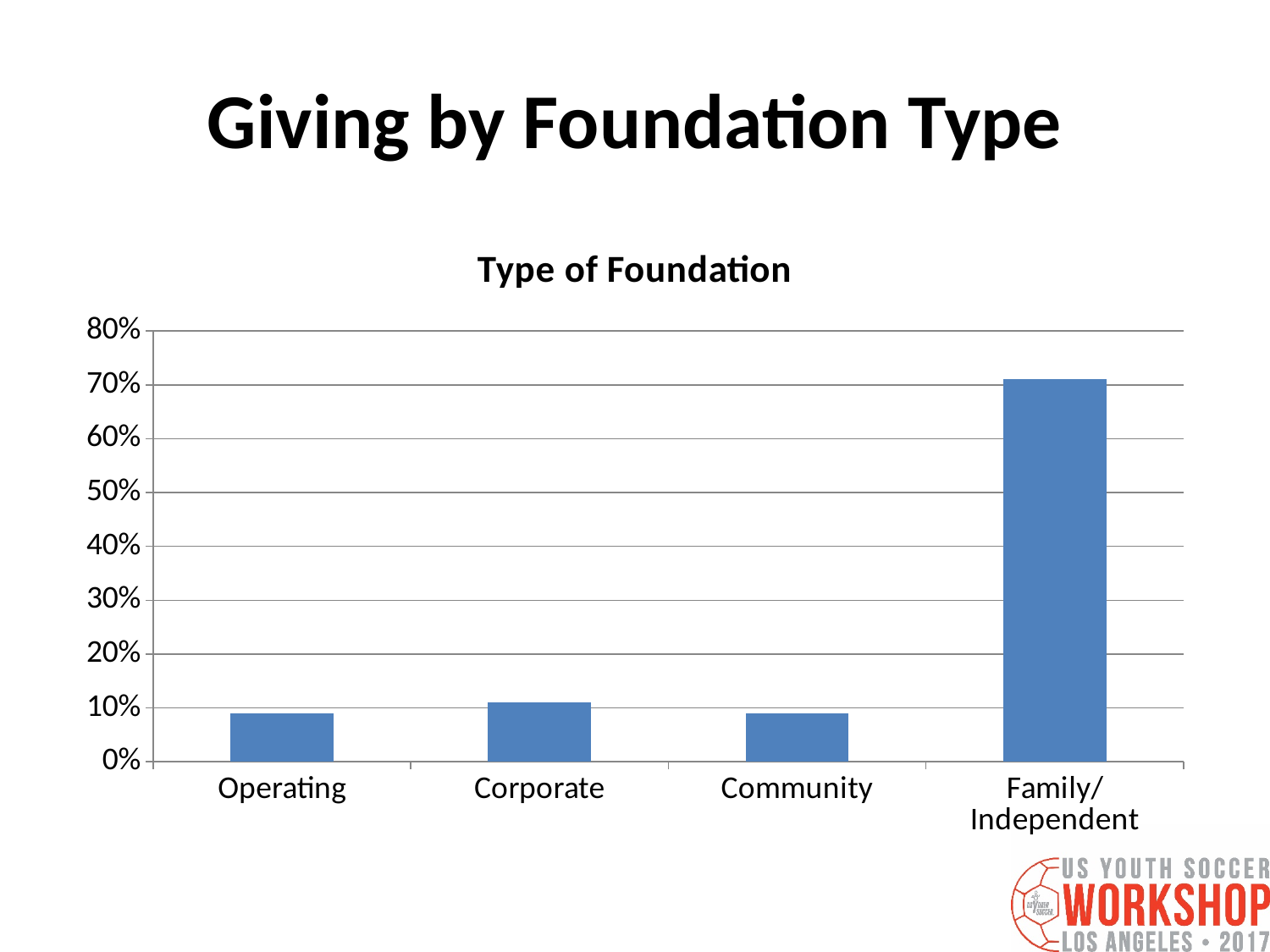
Is the value for Corporate greater or less than 20%? less How many foundation types are shown on the x axis of the chart? 4 Which is larger, the value for Corporate or the value for Operating? Corporate Which is larger, the value for Family/Independent or the value for Corporate? Family/Independent What is the title shown above the chart's plot area? Type of Foundation What colour are the bars in the chart? blue Is the value for Operating greater or less than 20%? less Is the value for Community greater or less than 30%? less Which foundation type has the highest value in the chart? Family/Independent What kind of chart is shown on the slide? bar chart